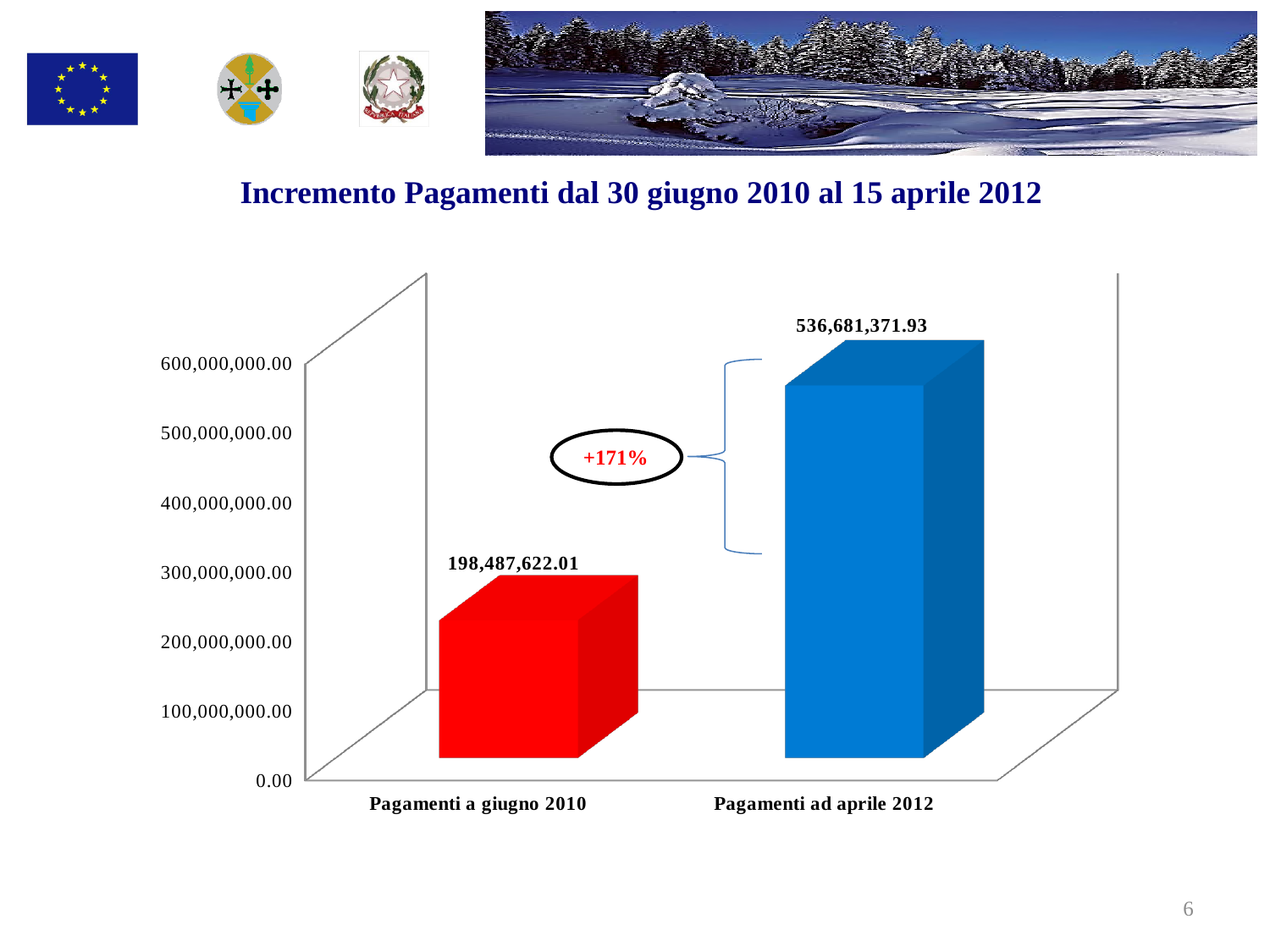
Which category has the highest value? Pagamenti ad aprile 2012 Which category has the lowest value? Pagamenti a giugno 2010 What percentage increase is shown in the annotation between the two bars? +171% Do the values rise or fall from Pagamenti a giugno 2010 to Pagamenti ad aprile 2012? rise What is the value for Pagamenti ad aprile 2012? 536,681,371.93 Which is larger, the value for Pagamenti a giugno 2010 or the value for Pagamenti ad aprile 2012? Pagamenti ad aprile 2012 What kind of chart is shown on the slide? bar chart What is the title of the chart? Incremento Pagamenti dal 30 giugno 2010 al 15 aprile 2012 Is the value for Pagamenti ad aprile 2012 greater or less than 400,000,000.00? greater What is the difference between the value for Pagamenti ad aprile 2012 and the value for Pagamenti a giugno 2010? 338,193,749.92 How many categories are shown on the x axis? 2 What is the value for Pagamenti a giugno 2010? 198,487,622.01